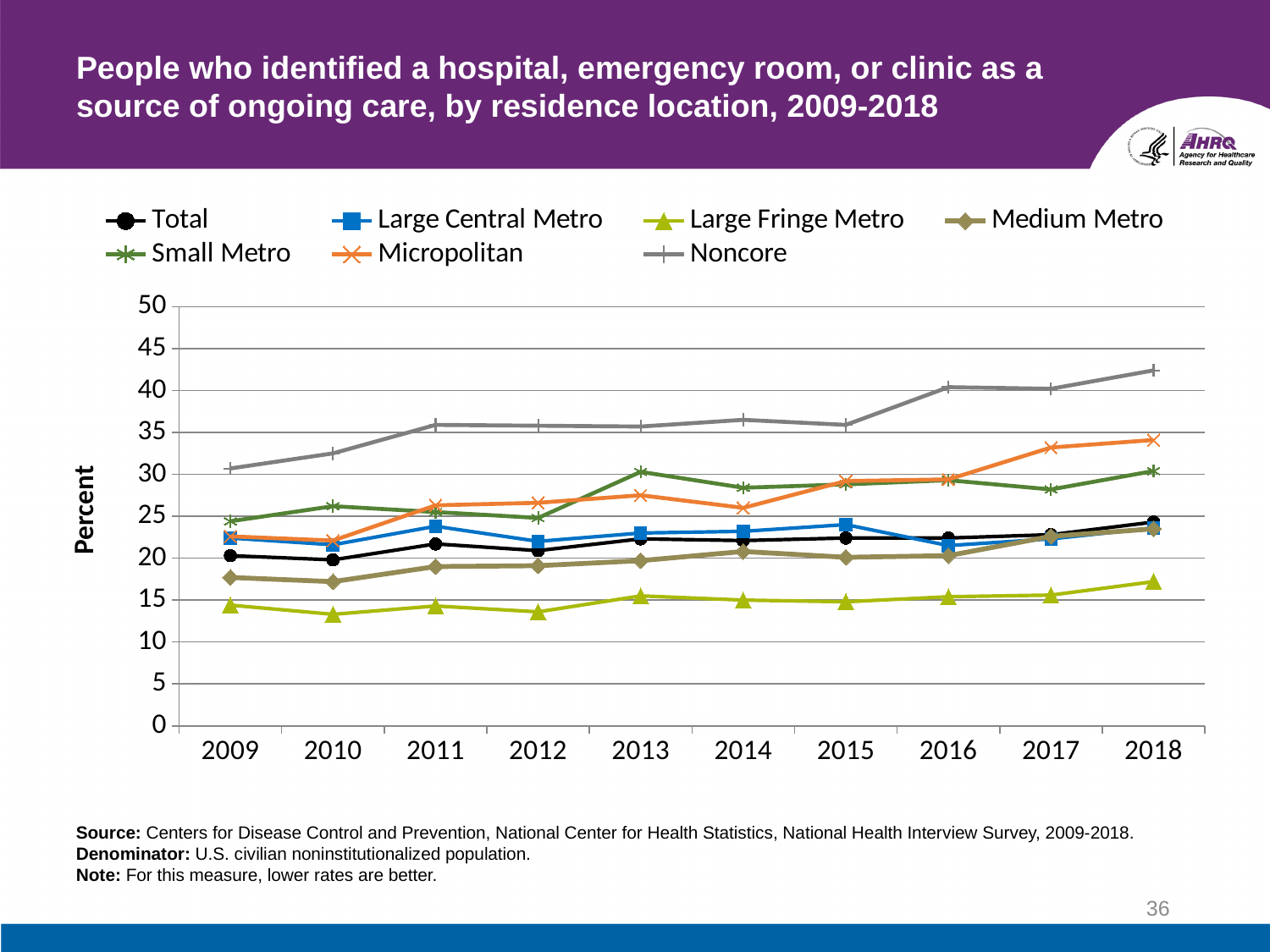
What kind of chart is shown on the slide? line chart How many series does the legend list? 7 Is the value for Noncore in 2018 greater or less than 40? greater Which residence location has the lowest value in 2018? Large Fringe Metro Is the value for Total in 2009 greater or less than 25? less What is the label on the y axis? Percent Which residence location has the highest value in 2018? Noncore In 2013, which is larger: Small Metro or Micropolitan? Small Metro Does the Noncore line rise or fall from 2009 to 2018? rise In 2017, which is larger: Micropolitan or Small Metro? Micropolitan Is the value for Large Fringe Metro in 2010 greater or less than 15? less How many years are shown along the x axis? 10